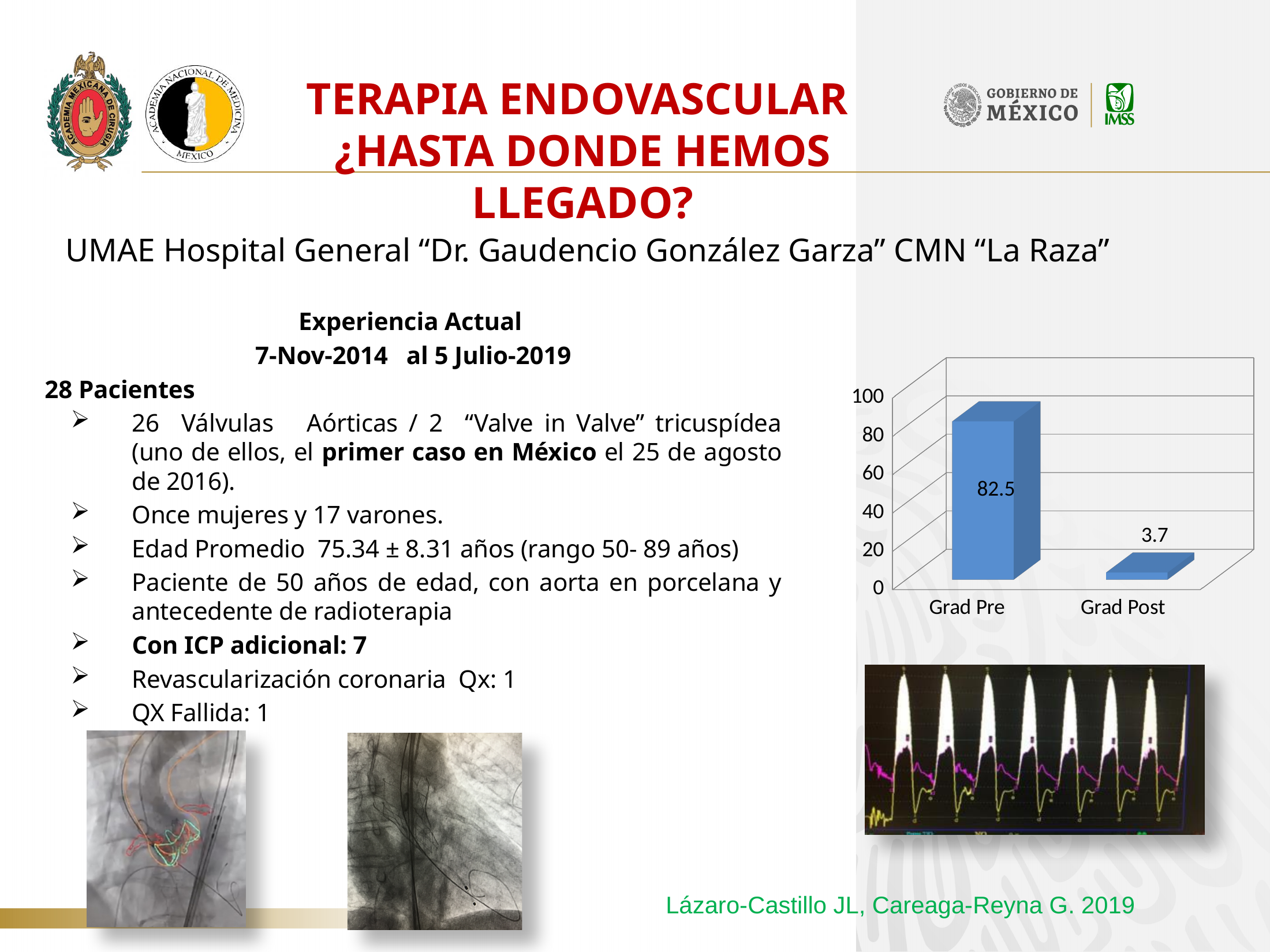
Is the value for Grad Pre greater or less than 60? greater What is the value for Grad Pre in the bar chart? 82.5 What is the value for Grad Post in the bar chart? 3.7 What is the difference between the Grad Pre and Grad Post values in the bar chart? 78.8 Which is larger in the bar chart, Grad Pre or Grad Post? Grad Pre What kind of chart is shown on the right of the slide? Bar chart How many categories are shown in the bar chart? 2 Which category has the highest value in the bar chart? Grad Pre Is the value for Grad Post greater or less than 20? less Which category has the lowest value in the bar chart? Grad Post What is the maximum value shown on the vertical axis of the bar chart? 100 Do the values fall or rise from Grad Pre to Grad Post in the bar chart? Fall